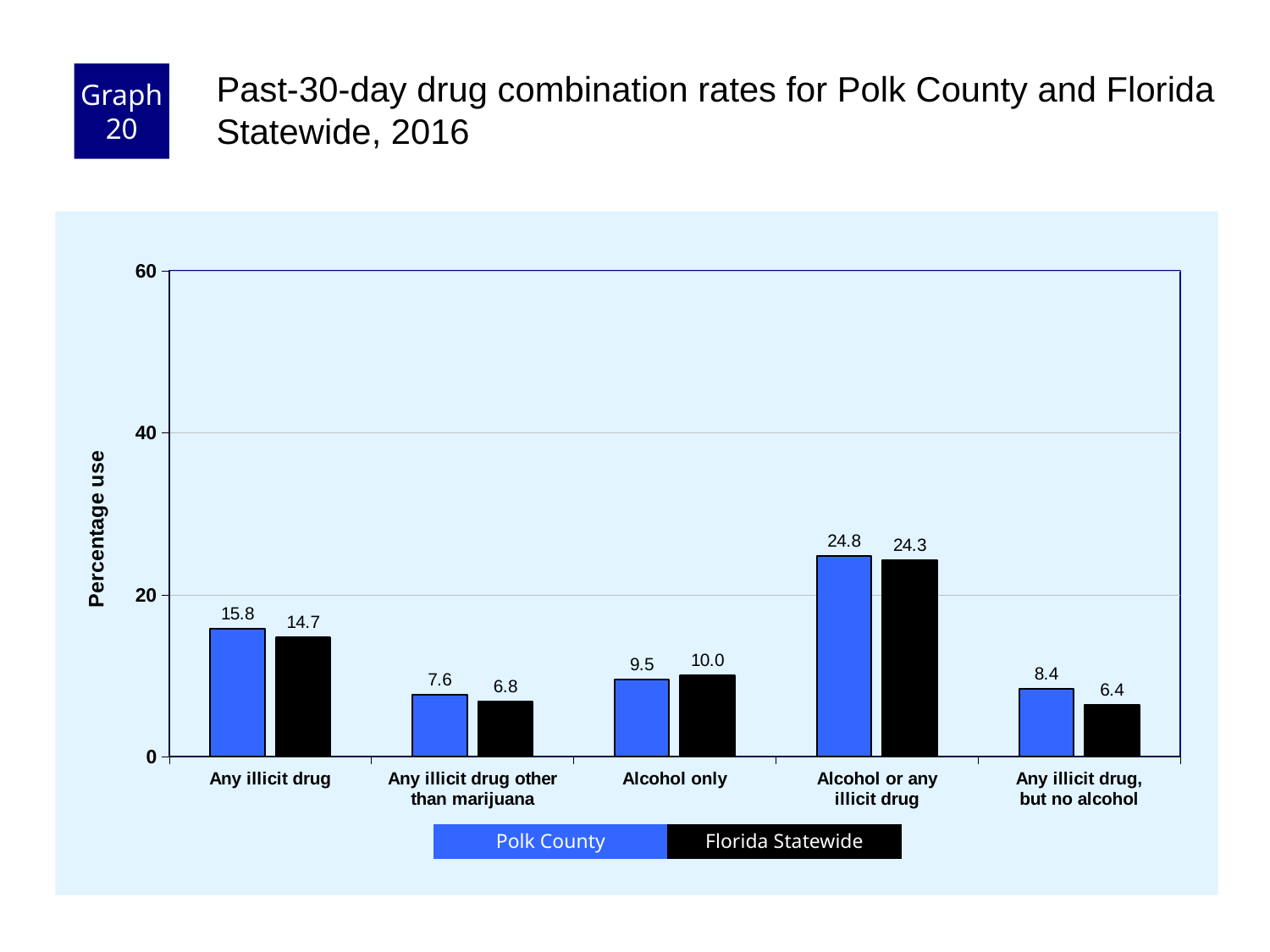
What is the Florida Statewide value for Any illicit drug, but no alcohol? 6.4 What is the Polk County value for Alcohol only? 9.5 Is the Florida Statewide value for Alcohol or any illicit drug greater or less than 20? greater For Alcohol only, which is larger: Polk County or Florida Statewide? Florida Statewide How many categories are shown on the x axis? 5 How many series does the legend list? 2 What is the label of the y axis? Percentage use Which category has the highest Polk County value? Alcohol or any illicit drug Which category has the lowest Florida Statewide value? Any illicit drug, but no alcohol What kind of chart is shown on the slide? Bar chart What is the Polk County value for Any illicit drug other than marijuana? 7.6 What is the difference between the Polk County and Florida Statewide values for Any illicit drug? 1.1